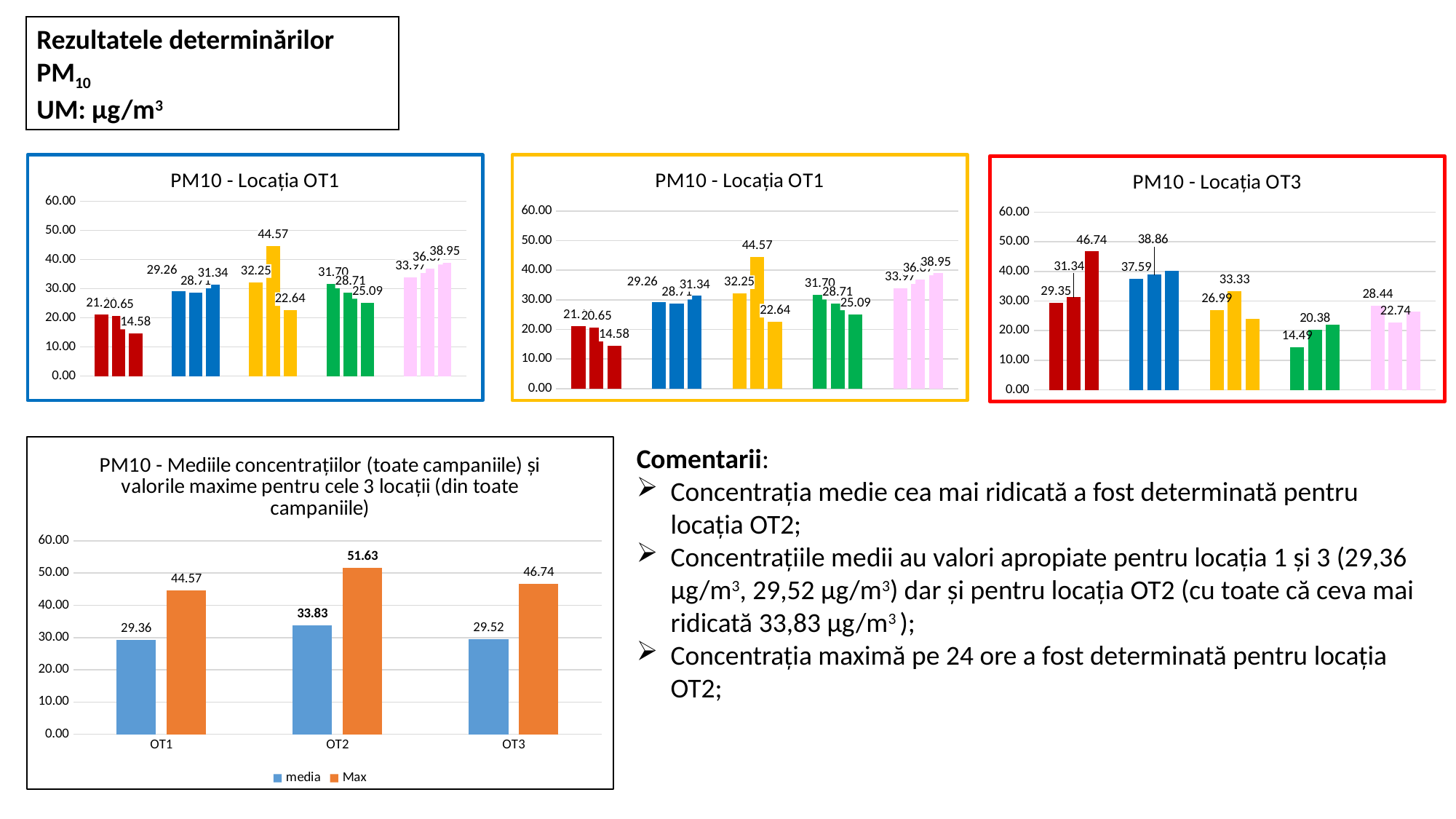
In the chart titled 'PM10 - Mediile concentrațiilor (toate campaniile) și valorile maxime pentru cele 3 locații', which location has the lowest 'media' value? OT1 In the chart titled 'PM10 - Mediile concentrațiilor (toate campaniile) și valorile maxime pentru cele 3 locații', which location has the highest 'Max' value? OT2 In the chart titled 'PM10 - Mediile concentrațiilor (toate campaniile) și valorile maxime pentru cele 3 locații', what is the 'Max' value for OT3? 46.74 In the chart titled 'PM10 - Mediile concentrațiilor (toate campaniile) și valorile maxime pentru cele 3 locații', how many series does the legend list? 2 In the chart titled 'PM10 - Locația OT3' (top right), what is the highest value labeled on any bar? 46.74 In the chart titled 'PM10 - Mediile concentrațiilor (toate campaniile) și valorile maxime pentru cele 3 locații', is the 'Max' value for OT1 or for OT3 larger? OT3 In the chart titled 'PM10 - Mediile concentrațiilor (toate campaniile) și valorile maxime pentru cele 3 locații', what is the 'media' value for OT2? 33.83 In the chart titled 'PM10 - Mediile concentrațiilor (toate campaniile) și valorile maxime pentru cele 3 locații', what is the difference between the 'Max' and 'media' values for OT2? 17.80 In the chart titled 'PM10 - Mediile concentrațiilor (toate campaniile) și valorile maxime pentru cele 3 locații', how many locations are shown on the x axis? 3 In the chart titled 'PM10 - Mediile concentrațiilor (toate campaniile) și valorile maxime pentru cele 3 locații', what is the 'media' value for OT1? 29.36 In the chart titled 'PM10 - Mediile concentrațiilor (toate campaniile) și valorile maxime pentru cele 3 locații', what colour are the 'Max' bars? Orange What kind of chart is the one titled 'PM10 - Mediile concentrațiilor (toate campaniile) și valorile maxime pentru cele 3 locații'? Bar chart